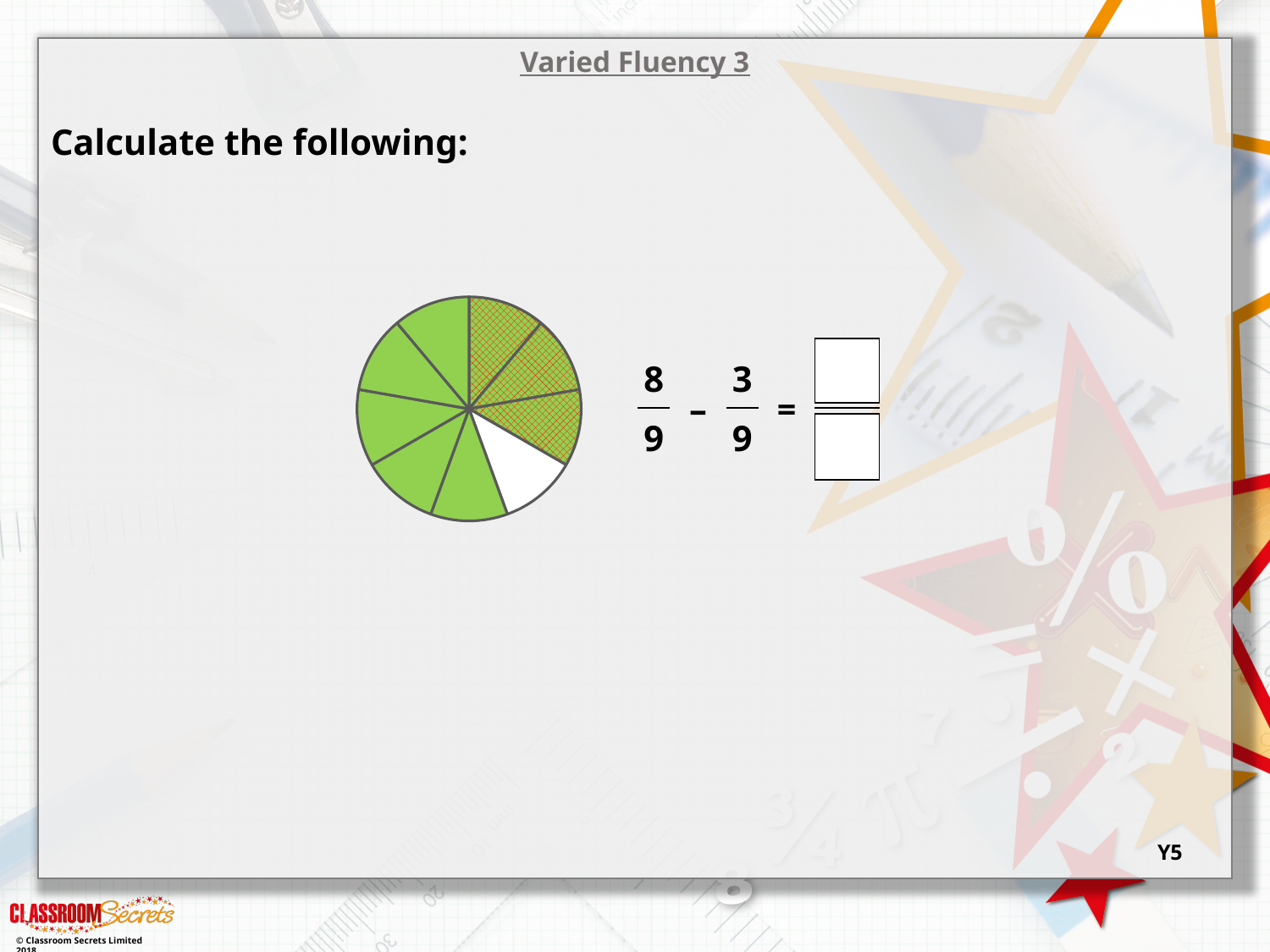
How many slices of the pie chart are shaded with orange cross-hatching? 3 How many equal slices is the pie chart divided into? 9 How many slices of the pie chart are plain green with no cross-hatching? 5 What fraction is written first in the calculation next to the pie chart? 8/9 What is the main fill colour of the shaded slices in the pie chart? green What kind of chart is shown on the slide? pie chart Are there more plain green slices or cross-hatched slices in the pie chart? plain green